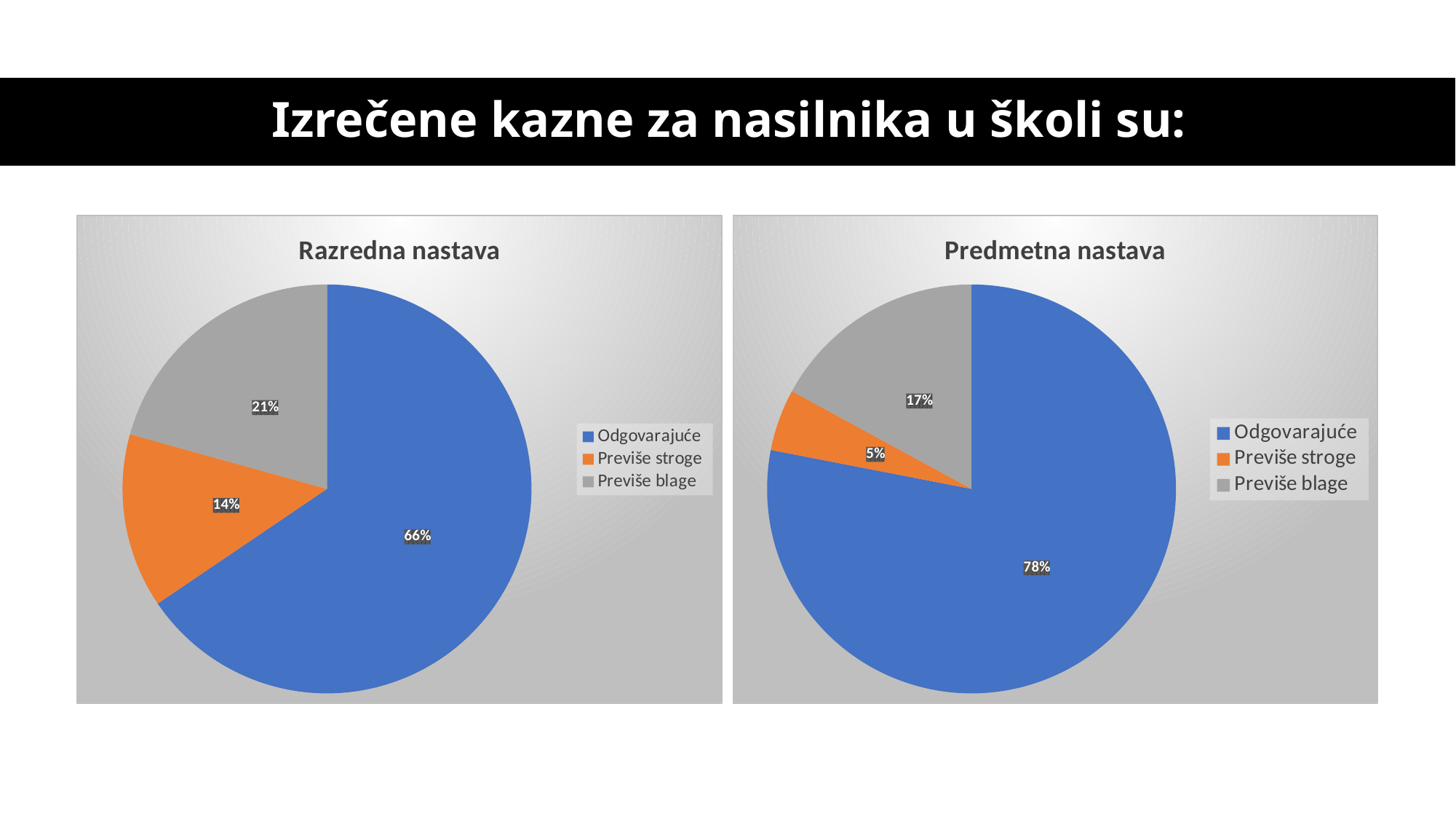
In the 'Razredna nastava' chart, which category has the largest slice? Odgovarajuće What is the title of the chart on the right side of the slide? Predmetna nastava How many categories does the 'Predmetna nastava' chart show? 3 Is the 'Odgovarajuće' share larger in the 'Razredna nastava' chart or the 'Predmetna nastava' chart? Predmetna nastava What type of chart is the 'Razredna nastava' chart? Pie chart In the 'Razredna nastava' chart, what percentage is shown for 'Previše blage'? 21% In the 'Predmetna nastava' chart, which category has the smallest slice? Previše stroge In the 'Razredna nastava' chart, what is the difference between 'Previše blage' and 'Previše stroge'? 7% In the 'Predmetna nastava' chart, what percentage is shown for 'Previše stroge'? 5% In the 'Razredna nastava' chart, what percentage is shown for 'Odgovarajuće'? 66% In the 'Razredna nastava' chart, what colour is the 'Previše stroge' slice? Orange In the 'Predmetna nastava' chart, what percentage is shown for 'Previše blage'? 17%